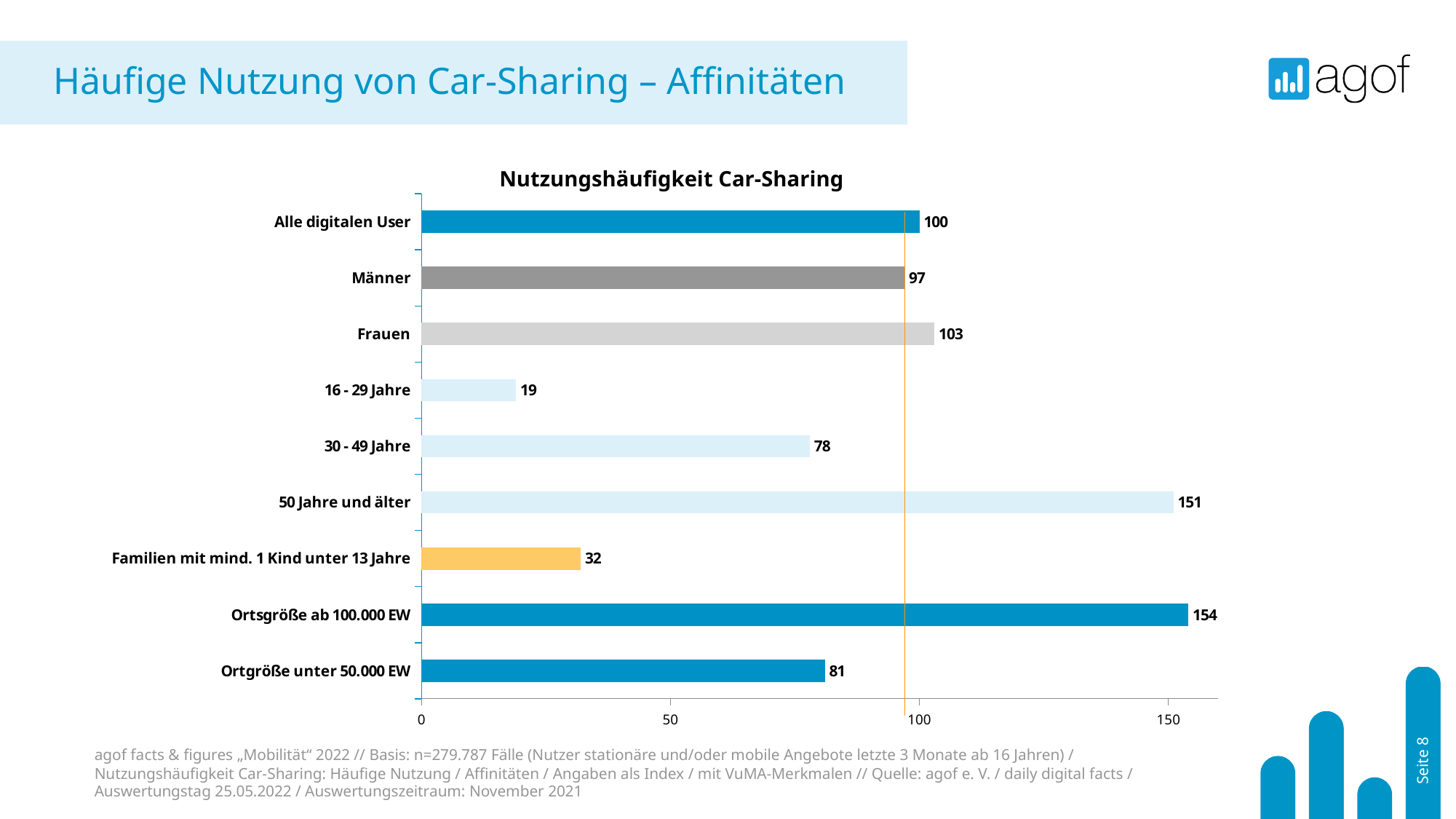
Which has a larger value, Männer or Frauen? Frauen What kind of chart is shown on the slide? bar chart What is the value for Frauen? 103 What is the title of the chart? Nutzungshäufigkeit Car-Sharing What is the value for Familien mit mind. 1 Kind unter 13 Jahre? 32 Which category has the lowest value? 16 - 29 Jahre What is the value for 50 Jahre und älter? 151 What is the difference between the values for Ortsgröße ab 100.000 EW and Ortgröße unter 50.000 EW? 73 What is the difference between the values for 50 Jahre und älter and 16 - 29 Jahre? 132 How many categories are shown in the chart? 9 Is the value for 30 - 49 Jahre greater or less than 100? less Which category has the highest value? Ortsgröße ab 100.000 EW